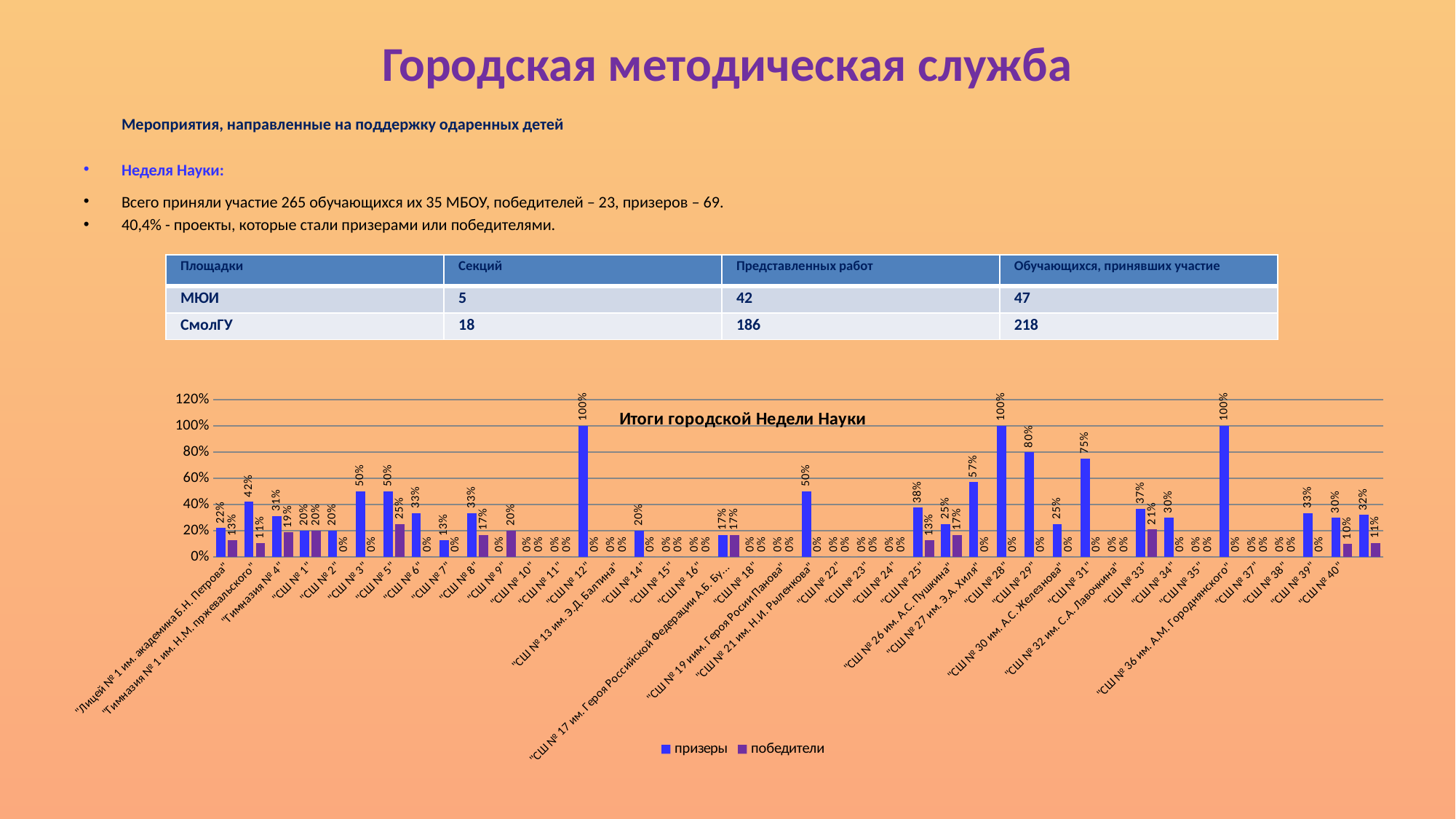
In the chart 'Итоги городской Недели Науки', what is the value of призеры for СШ № 12? 100% In the chart 'Итоги городской Недели Науки', what is the difference between призеры and победители for СШ № 25? 25% In the chart 'Итоги городской Недели Науки', which school has the highest победители value? СШ № 5 In the chart 'Итоги городской Недели Науки', which has a higher призеры value: СШ № 31 or СШ № 29? СШ № 29 What kind of chart is 'Итоги городской Недели Науки'? Bar chart In the chart 'Итоги городской Недели Науки', what is the value of призеры for СШ № 27 им. Э.А. Хиля? 57% In the chart 'Итоги городской Недели Науки', what is the value of победители for Гимназия № 4? 19% How many series does the legend of the chart 'Итоги городской Недели Науки' list? 2 In the chart 'Итоги городской Недели Науки', what is the value of призеры for СШ № 29? 80% In the chart 'Итоги городской Недели Науки', which has a higher победители value: СШ № 33 or СШ № 8? СШ № 33 What is the title of the chart on the slide? Итоги городской Недели Науки In the chart 'Итоги городской Недели Науки', what is the value of победители for СШ № 5? 25%